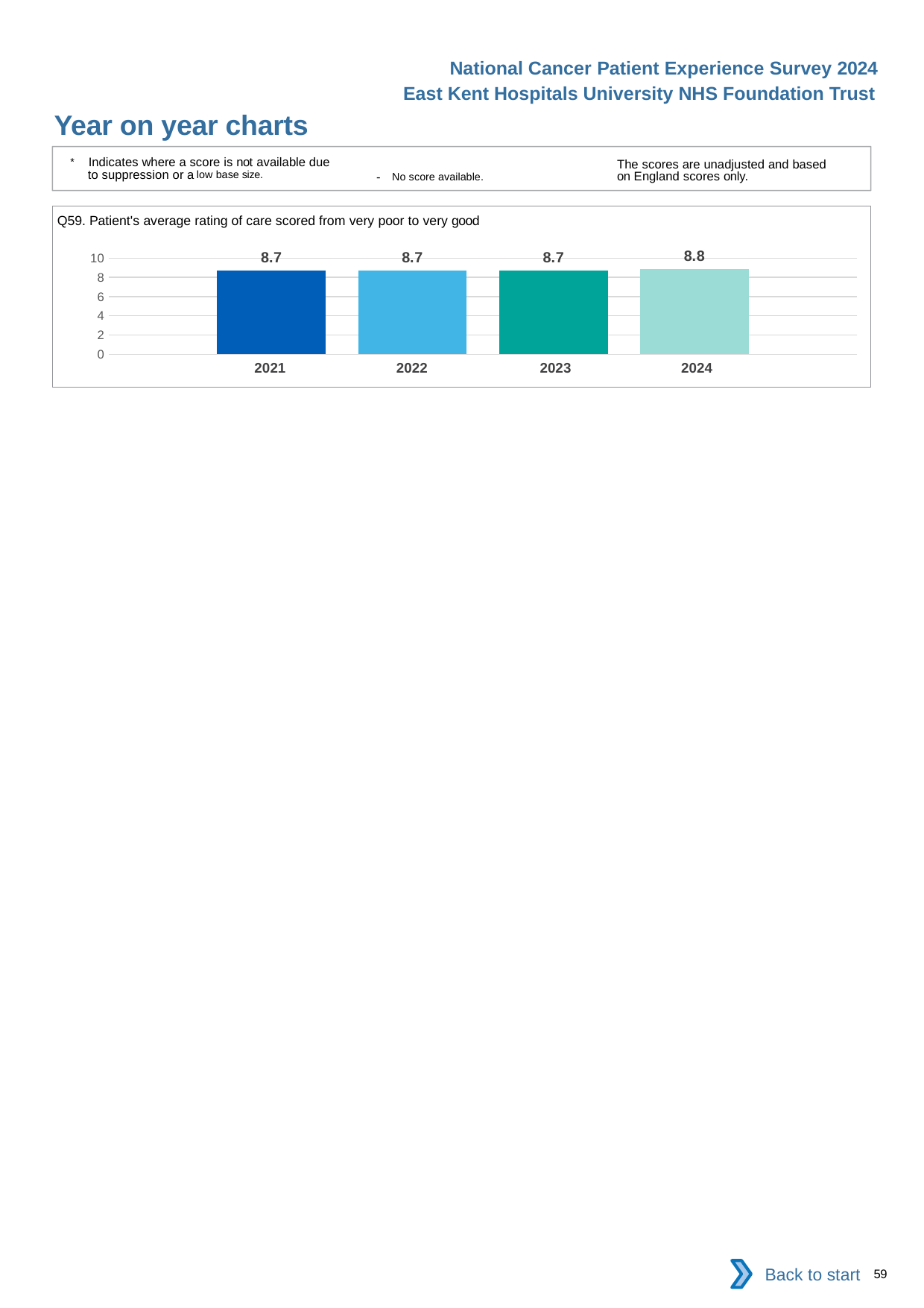
How many years are shown on the chart? 4 Is the value for 2024 larger than the value for 2021? Yes What is the value for 2021? 8.7 What is the difference between the values for 2024 and 2023? 0.1 What is the title of the chart? Q59. Patient's average rating of care scored from very poor to very good What is the value for 2024? 8.8 Is the value for 2023 greater or less than 6? greater What is the value for 2022? 8.7 What kind of chart is shown? Bar chart Do the values rise or fall from 2023 to 2024? Rise Which year has the highest value? 2024 What is the maximum value shown on the y axis? 10